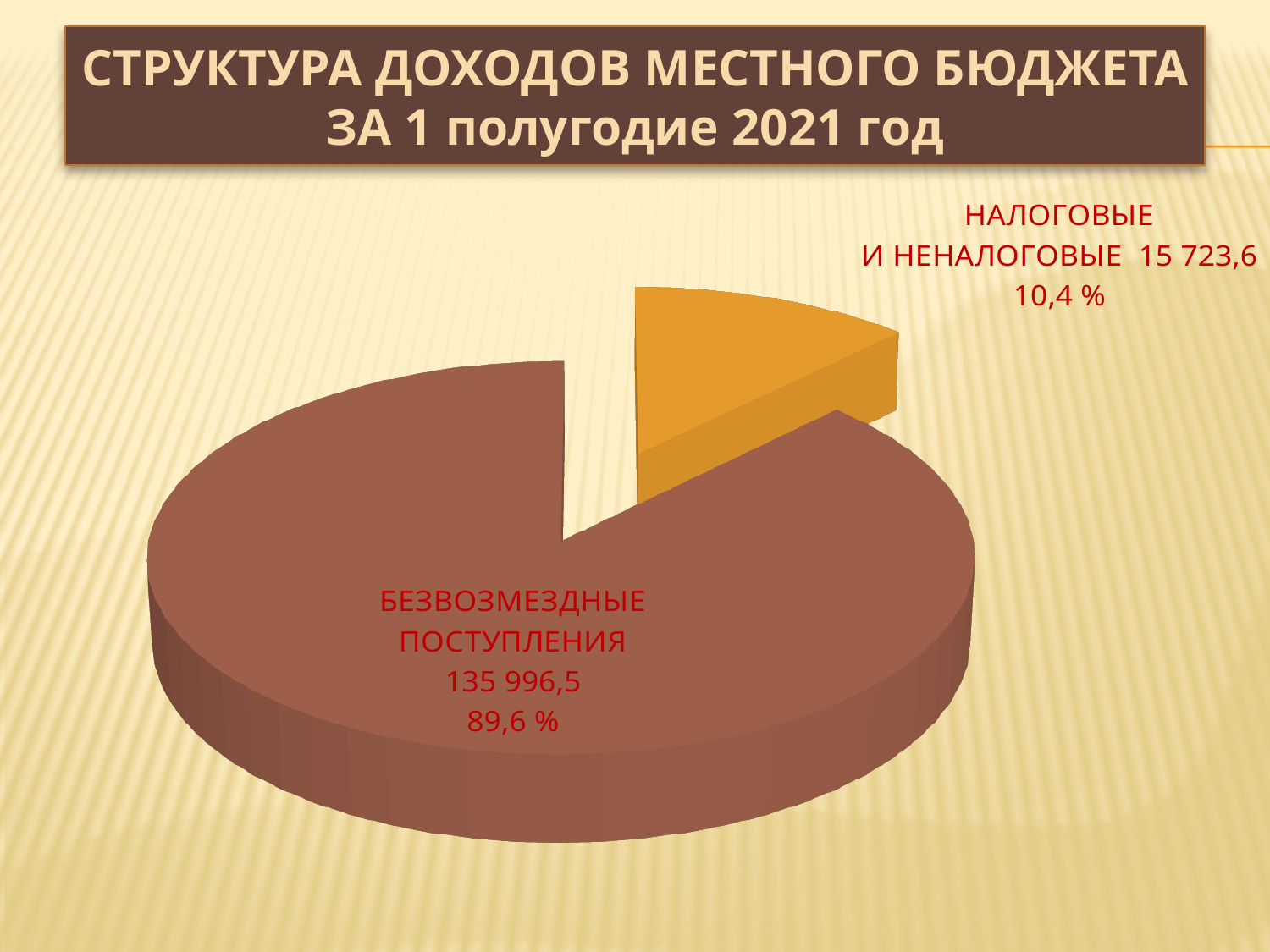
What share of the pie does БЕЗВОЗМЕЗДНЫЕ ПОСТУПЛЕНИЯ represent? 89,6 % How many categories are shown in the pie chart? 2 What share of the pie does НАЛОГОВЫЕ И НЕНАЛОГОВЫЕ represent? 10,4 % What value is shown for БЕЗВОЗМЕЗДНЫЕ ПОСТУПЛЕНИЯ? 135 996,5 What colour is the slice for НАЛОГОВЫЕ И НЕНАЛОГОВЫЕ? Orange What kind of chart is shown on the slide? Pie chart What is the total of the two values shown on the pie chart? 151 720,1 Which category has the smallest slice of the pie? НАЛОГОВЫЕ И НЕНАЛОГОВЫЕ Which category has the largest slice of the pie? БЕЗВОЗМЕЗДНЫЕ ПОСТУПЛЕНИЯ Which is larger: БЕЗВОЗМЕЗДНЫЕ ПОСТУПЛЕНИЯ or НАЛОГОВЫЕ И НЕНАЛОГОВЫЕ? БЕЗВОЗМЕЗДНЫЕ ПОСТУПЛЕНИЯ What value is shown for НАЛОГОВЫЕ И НЕНАЛОГОВЫЕ? 15 723,6 What is the difference between the values for БЕЗВОЗМЕЗДНЫЕ ПОСТУПЛЕНИЯ and НАЛОГОВЫЕ И НЕНАЛОГОВЫЕ? 120 272,9